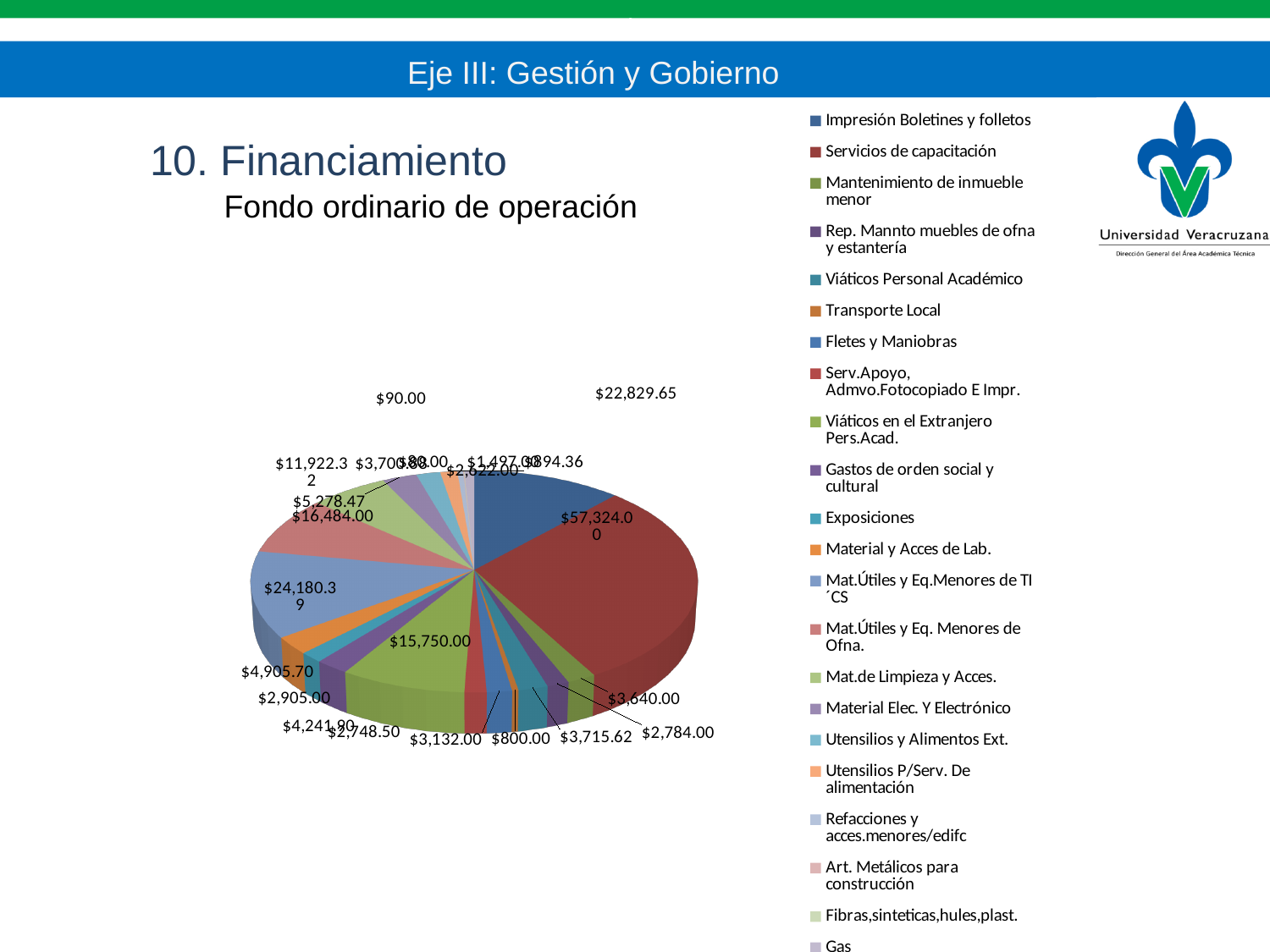
Which legend entry is listed last in the pie chart's legend? Gas How many entries does the legend of the pie chart list? 22 What is the largest value labelled on the pie chart? $57,324.00 What is the subtitle shown above the pie chart? Fondo ordinario de operación What kind of chart is shown on the slide? pie chart Which is larger, the slice labelled $24,180.39 or the slice labelled $16,484.00? $24,180.39 What is the smallest value labelled on the pie chart? $80.00 What is the difference between the slice labelled $15,750.00 and the slice labelled $3,640.00? $12,110.00 What is the value of the slice for Impresión Boletines y folletos? $22,829.65 Which is larger, the slice for Servicios de capacitación or the slice for Impresión Boletines y folletos? Servicios de capacitación What is the value of the slice for Servicios de capacitación? $57,324.00 What is the difference between the slice labelled $57,324.00 and the slice labelled $22,829.65? $34,494.35